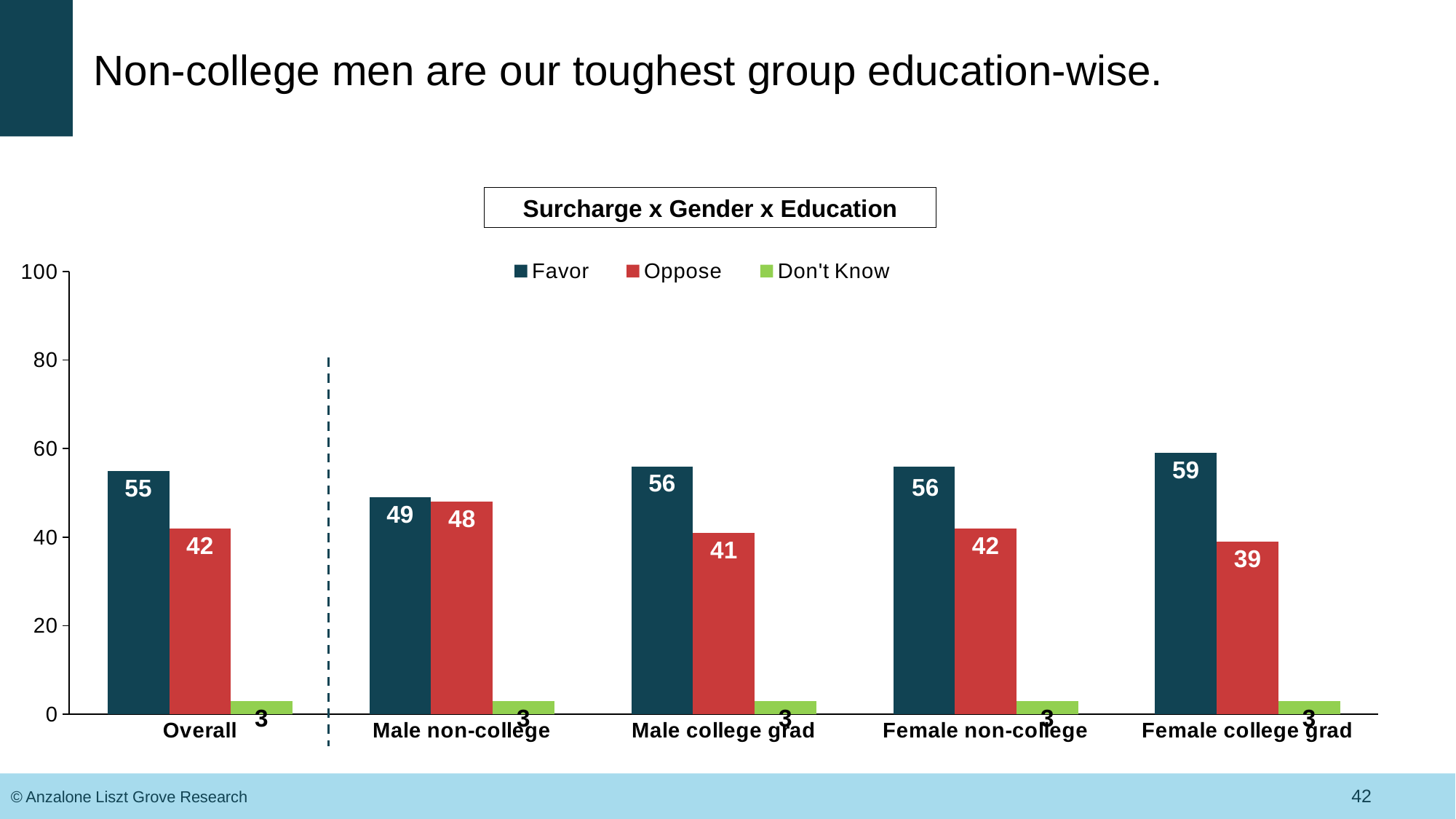
How many categories are shown on the x axis? 5 Which is larger for Male college grad, Favor or Oppose? Favor What is the title of the chart? Surcharge x Gender x Education What is the Oppose value for Female college grad? 39 What is the Favor value for Overall? 55 What kind of chart is shown on the slide? Bar chart How many series does the legend list? 3 Which category has the highest Favor value? Female college grad What is the Favor value for Male non-college? 49 What is the difference between Favor and Oppose for Female college grad? 20 What is the difference between Favor and Oppose for Male non-college? 1 Which category has the lowest Favor value? Male non-college